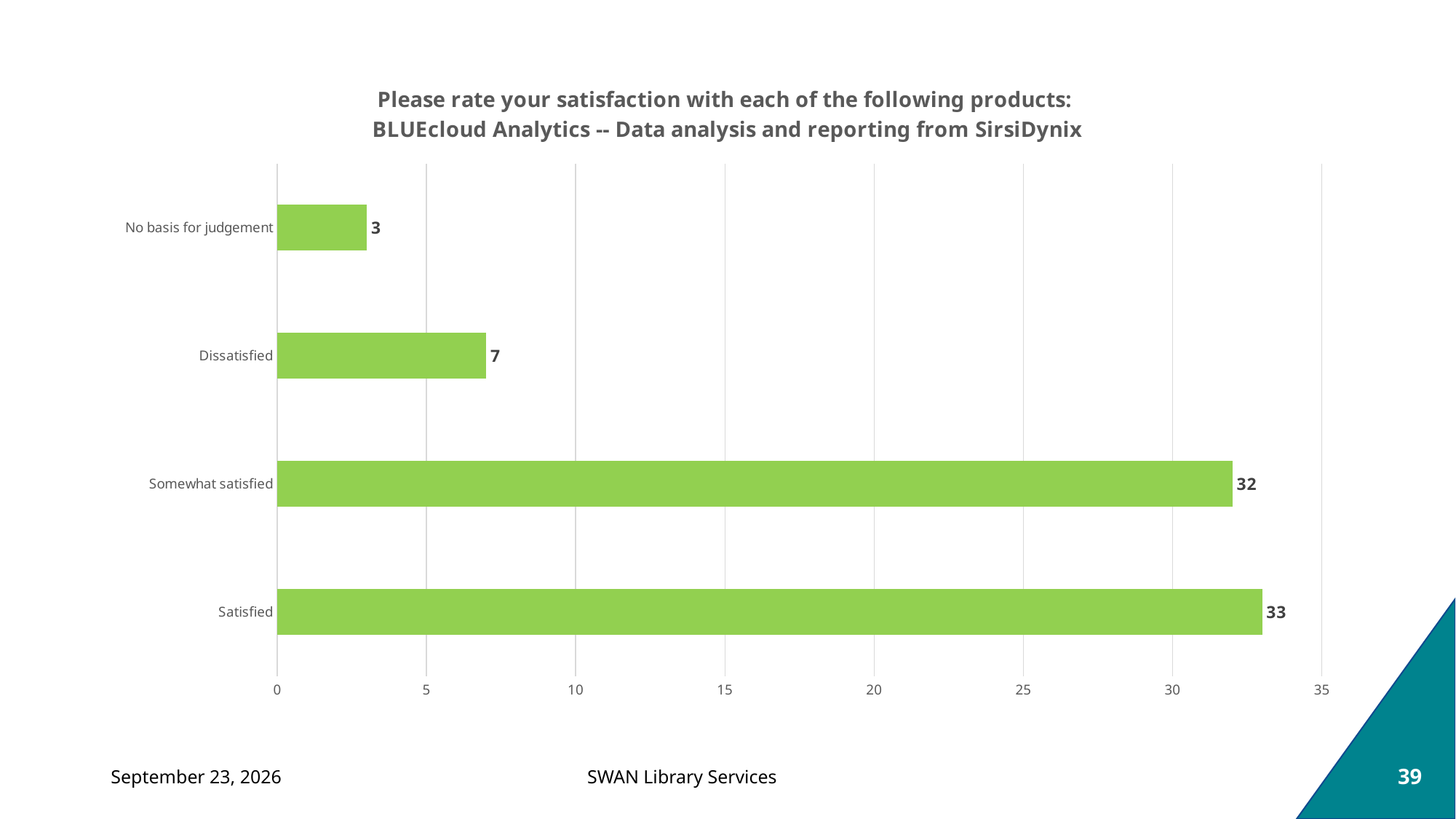
What is the value for Somewhat satisfied? 32 What is the difference between the values for Satisfied and Dissatisfied? 26 What is the value for No basis for judgement? 3 Which category has the highest value? Satisfied Is the value for Somewhat satisfied greater or less than 30? greater How many categories are shown in the chart? 4 Which category has the lowest value? No basis for judgement What is the value for Satisfied? 33 Which is larger, the value for Dissatisfied or the value for No basis for judgement? Dissatisfied What kind of chart is shown on the slide? bar chart What is the value for Dissatisfied? 7 What is the difference between the values for Somewhat satisfied and No basis for judgement? 29